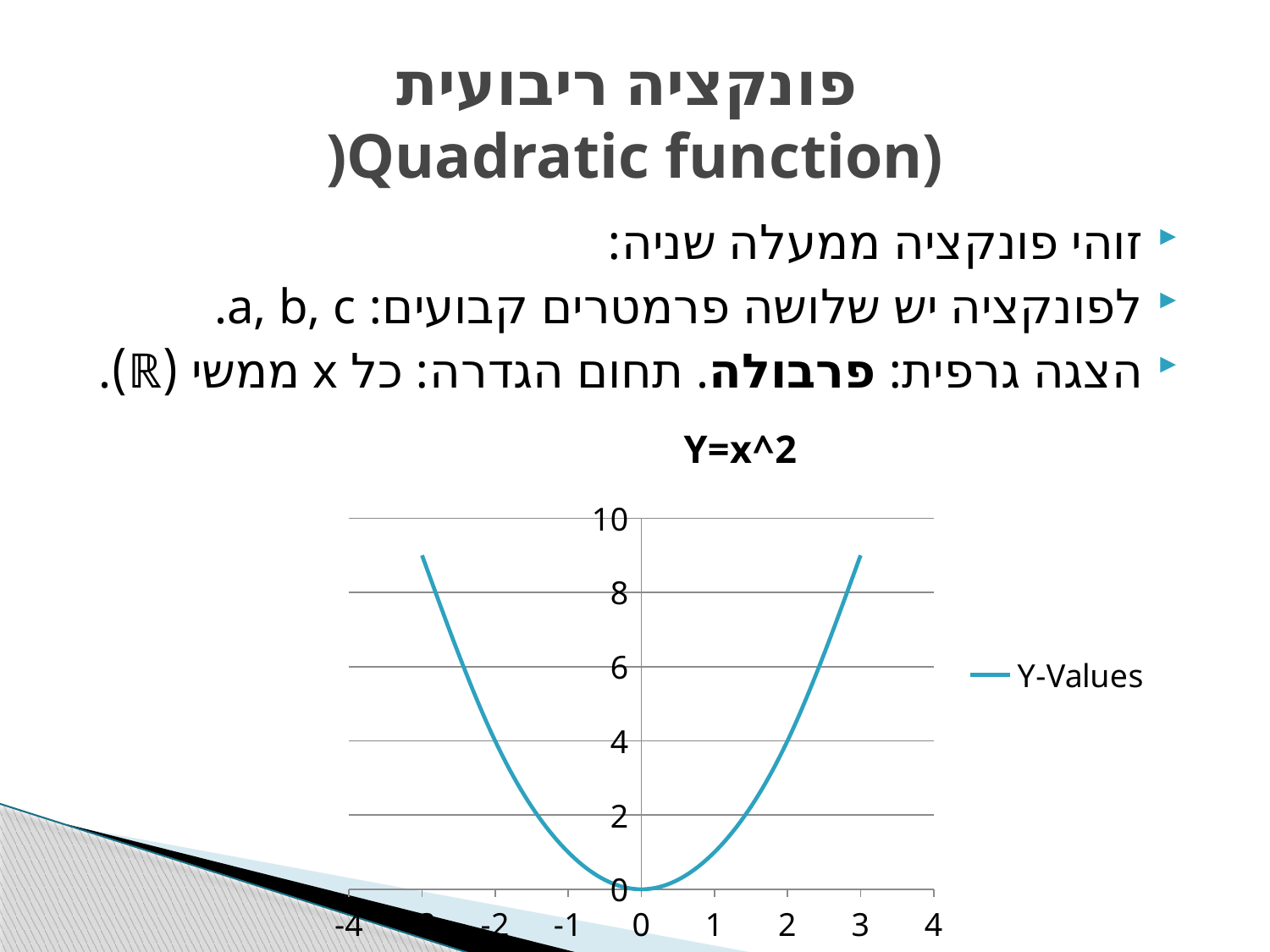
Do the Y-Values rise or fall as x increases from -3 to 0? fall What is the value of Y-Values at x = 0? 0 What is the title of the chart? Y=x^2 Which is larger, the value of Y-Values at x = 3 or at x = 1? x = 3 How many series does the chart legend list? 1 At which x value does the curve reach its lowest point? 0 What is the name of the series shown in the chart legend? Y-Values Is the value of Y-Values at x = 3 greater or less than 8? greater What kind of chart is shown on the slide? line chart Do the Y-Values rise or fall as x increases from 0 to 3? rise Is the value of Y-Values at x = 1 greater or less than 2? less Is the value of Y-Values at x = -3 greater or less than 8? greater